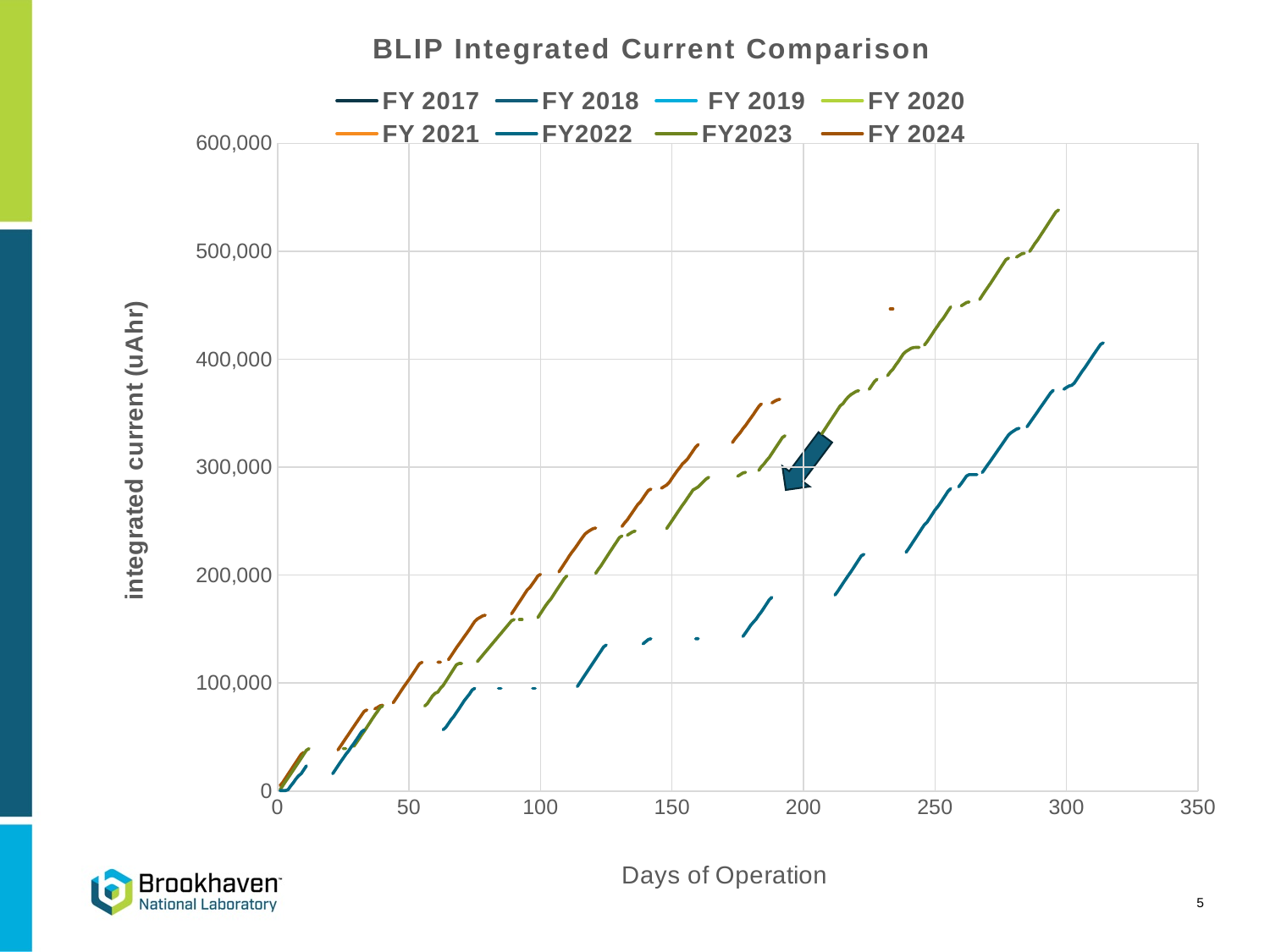
What is the label of the vertical axis? integrated current (uAhr) Do the plotted lines rise or fall as Days of Operation increases? rise Is the value of the FY 2024 line at 150 days of operation greater or less than 200,000? greater Is the highest value reached by any line on the chart greater or less than 500,000? greater Is the highest value reached by any line on the chart greater or less than 600,000? less How many series does the legend list? 8 Which series reaches the highest integrated current on the chart, FY2023 or FY 2024? FY2023 What kind of chart is shown on the slide? line chart What is the title of the chart? BLIP Integrated Current Comparison